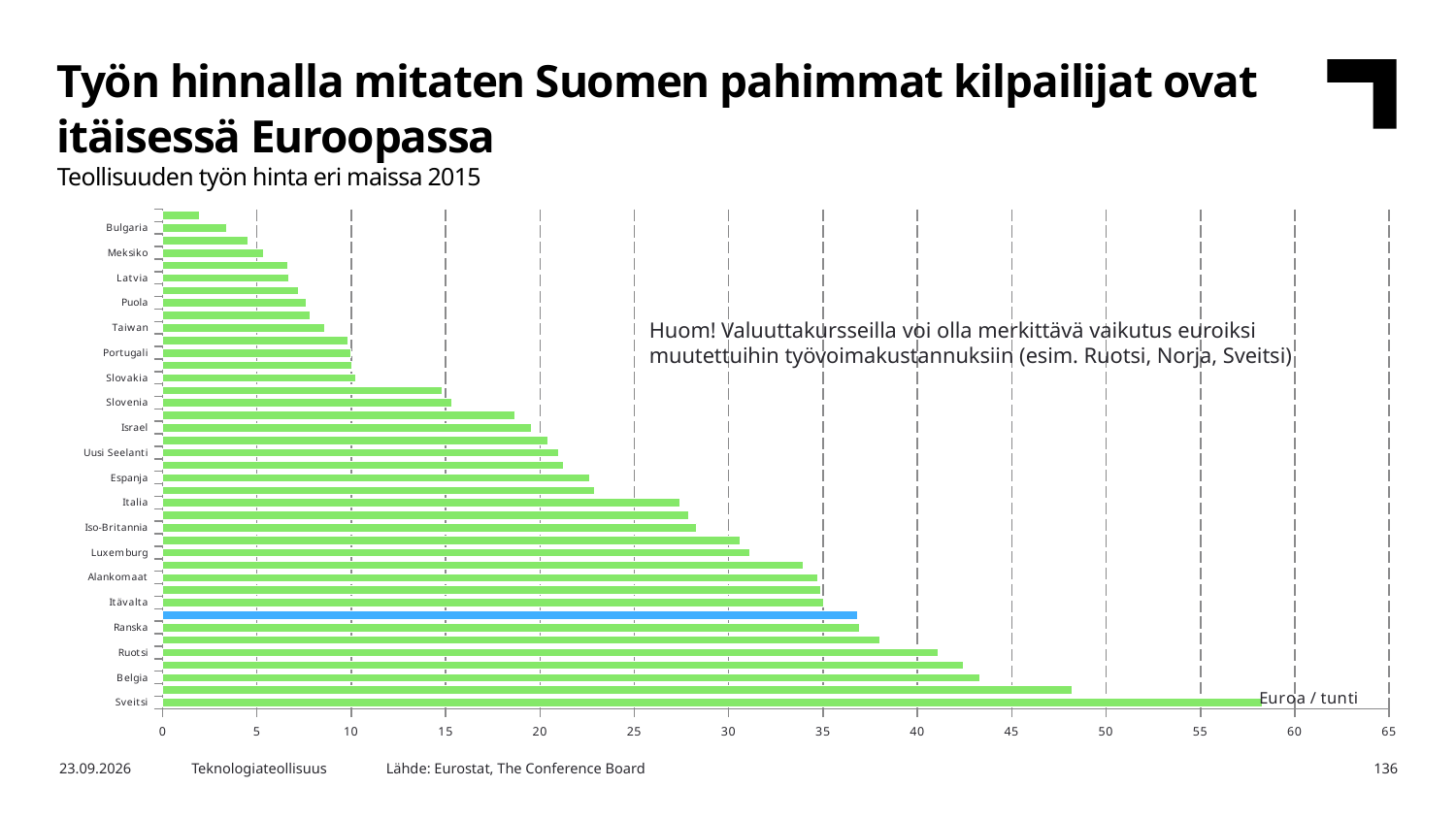
Is the value for Puola greater or less than 10? less What kind of chart is shown on the slide? bar chart What is the subtitle of the chart? Teollisuuden työn hinta eri maissa 2015 Which has the larger value, Belgia or Ruotsi? Belgia Is the value for Bulgaria greater or less than 5? less Is the value for Sveitsi greater or less than 55? greater Which country has the highest labour cost in the chart? Sveitsi What unit is shown on the chart's value axis? Euroa / tunti Which has the larger value, Sveitsi or Bulgaria? Sveitsi